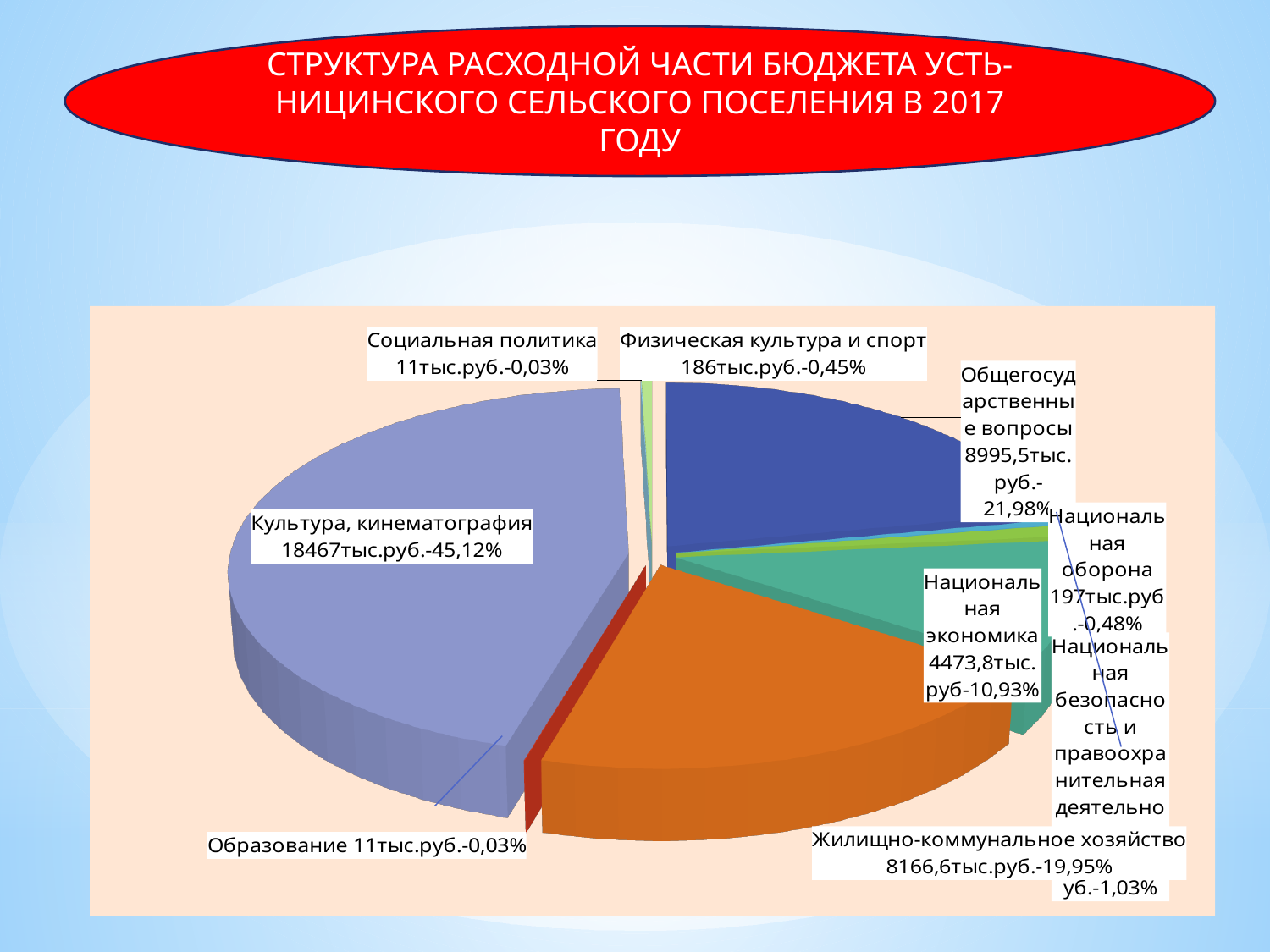
What percentage is shown for Социальная политика? 0,03% Which category has the largest share of the pie? Культура, кинематография What is the difference in percentage points between the shares of Культура, кинематография and Общегосударственные вопросы? 23,14% How many categories are shown in the pie chart? 9 What kind of chart is shown on the slide? pie chart What percentage is shown for Национальная экономика? 10,93% What share of the budget expenditure does Культура, кинематография account for? 45,12% What percentage is shown for Национальная оборона? 0,48% What is the value shown for Жилищно-коммунальное хозяйство? 8166,6тыс.руб. Which is larger, the share for Общегосударственные вопросы or for Жилищно-коммунальное хозяйство? Общегосударственные вопросы What is the value shown for Общегосударственные вопросы? 8995,5тыс.руб. What is the value shown for Физическая культура и спорт? 186тыс.руб.